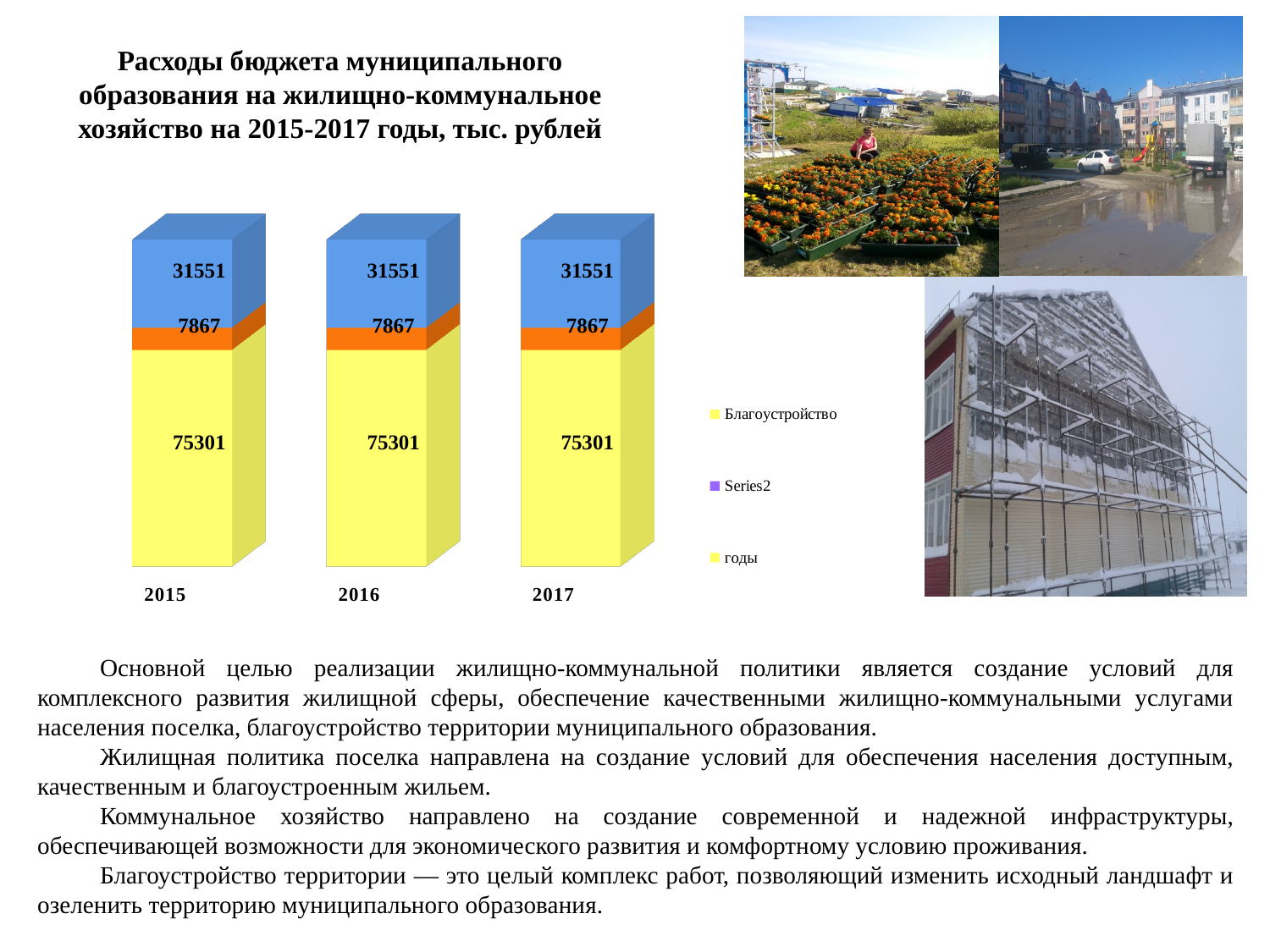
Do the bar totals rise, fall or stay the same from 2015 to 2017? Stay the same What is the value of the orange (middle) segment of the 2016 bar? 7867 What is the total of the stacked bar for 2016? 114719 What kind of chart is shown on the slide? Stacked bar chart Which segment of the 2017 bar is the smallest? The orange (middle) segment, 7867 How many years (categories) are shown on the x axis of the chart? 3 What is the difference between the yellow segment and the blue segment in the 2015 bar? 43750 What is the value of the yellow (bottom) segment of the 2015 bar? 75301 Which segment of the 2015 bar is the largest? The yellow (bottom) segment, 75301 How many entries does the chart legend list? 3 What is the value of the blue (top) segment of the 2017 bar? 31551 What unit of measurement is stated in the chart title? тыс. рублей